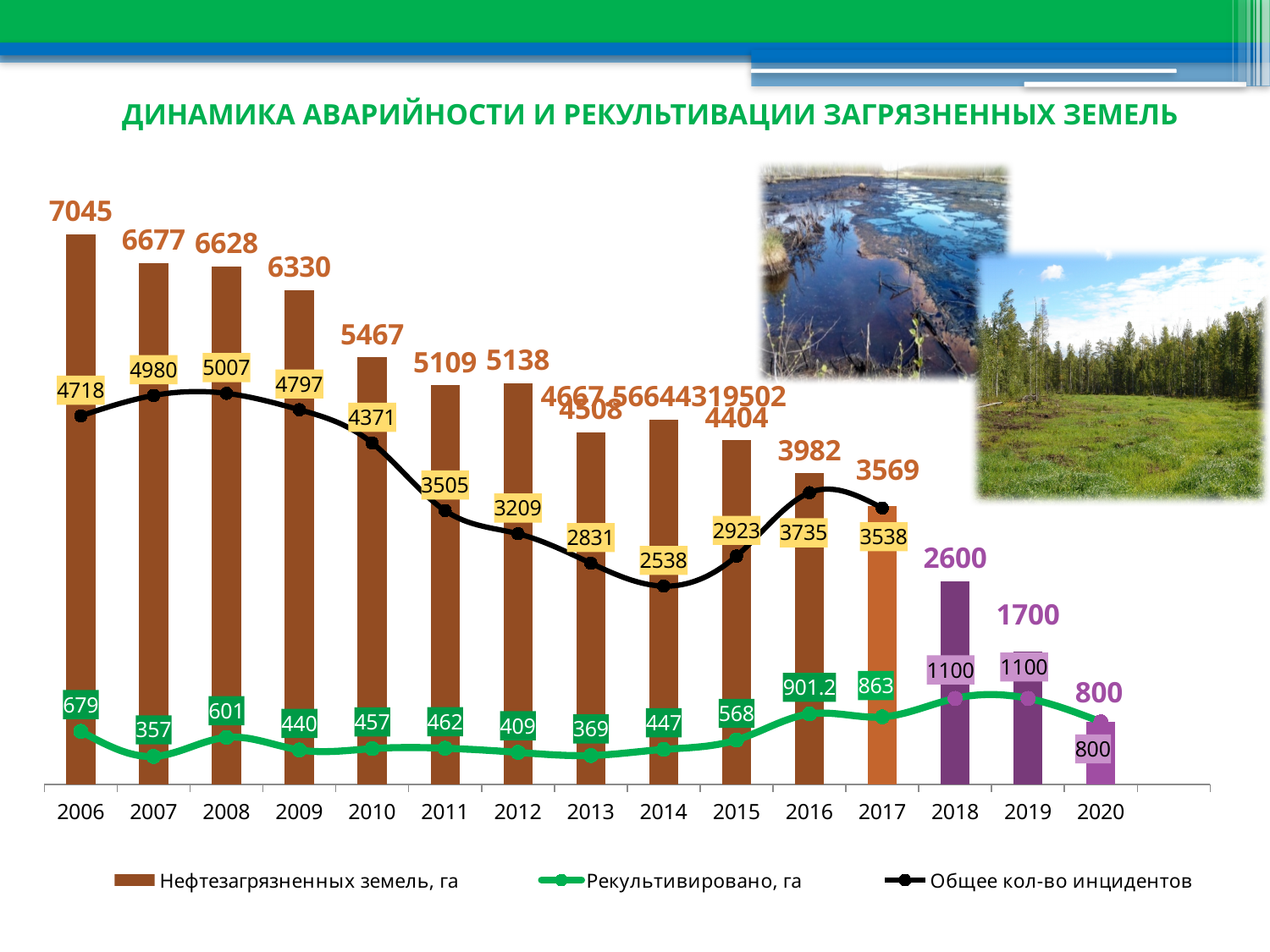
What is the value of Рекультивировано, га for 2007? 357 How many years are shown on the x axis? 15 Which year has the highest value of Нефтезагрязненных земель, га? 2006 What is the value of Общее кол-во инцидентов for 2008? 5007 Do the values of Нефтезагрязненных земель, га rise or fall from 2006 to 2020? Fall What is the difference between Нефтезагрязненных земель, га in 2006 and in 2017? 3476 How many series does the legend list? 3 What is the value of Нефтезагрязненных земель, га for 2006? 7045 Which year has the larger value of Общее кол-во инцидентов, 2007 or 2009? 2007 What is the value of Рекультивировано, га for 2016? 901.2 Which year has the lowest value of Нефтезагрязненных земель, га? 2020 What kind of chart is shown on the slide? Combined bar and line chart